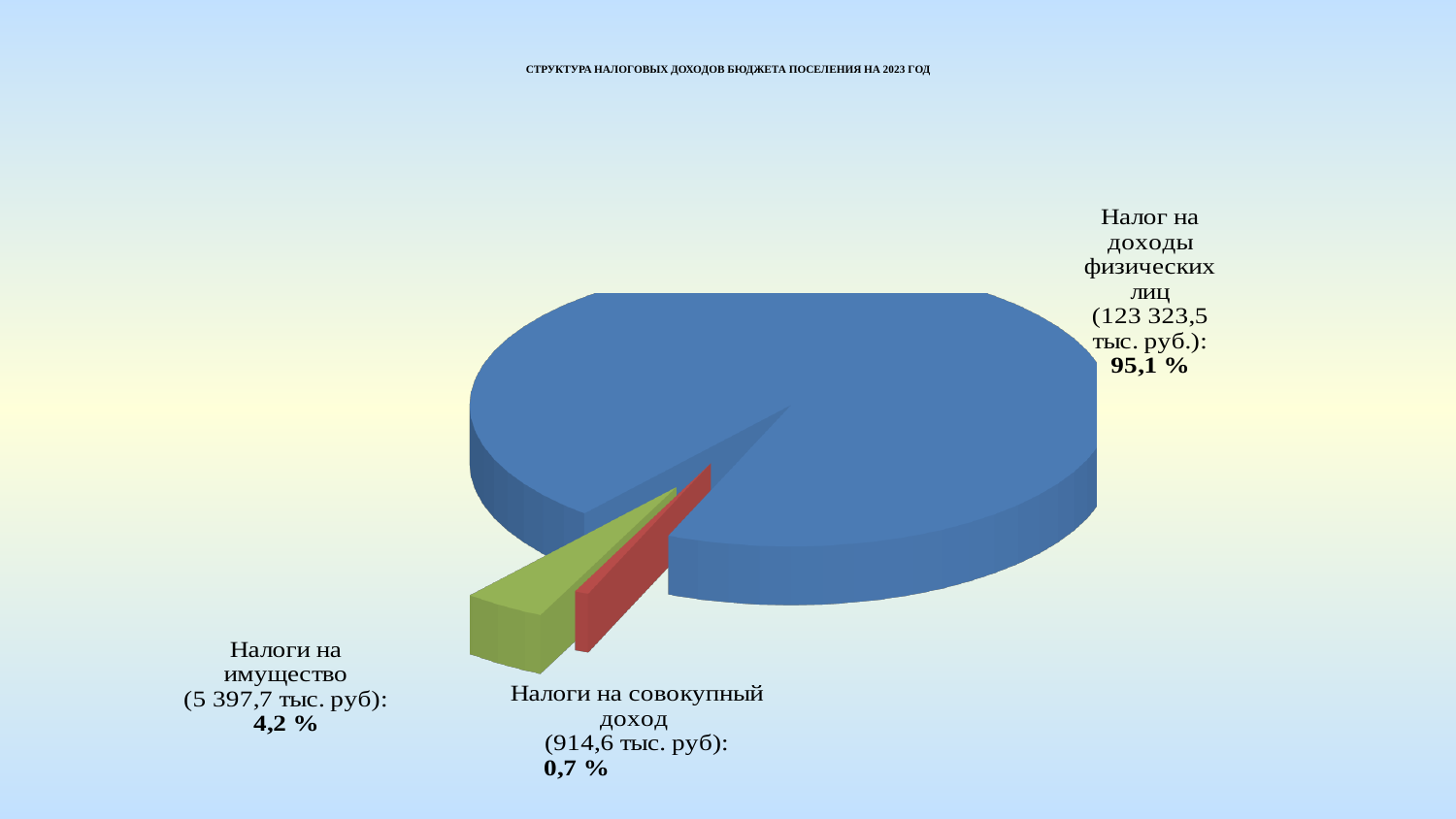
What share of the pie does "Налоги на имущество" represent? 4,2 % Which category has the smallest slice of the pie? Налоги на совокупный доход What share of the pie does "Налоги на совокупный доход" represent? 0,7 % Which is larger: the value for "Налоги на имущество" or the value for "Налоги на совокупный доход"? Налоги на имущество What is the value in тыс. руб. for "Налог на доходы физических лиц"? 123 323,5 тыс. руб. What share of the pie does "Налог на доходы физических лиц" represent? 95,1 % Which category has the largest slice of the pie? Налог на доходы физических лиц What is the value in тыс. руб. for "Налоги на имущество"? 5 397,7 тыс. руб What is the value in тыс. руб. for "Налоги на совокупный доход"? 914,6 тыс. руб What kind of chart is shown on the slide? Pie chart What is the difference in percentage points between the shares of "Налоги на имущество" and "Налоги на совокупный доход"? 3,5 % How many slices does the pie chart have? 3